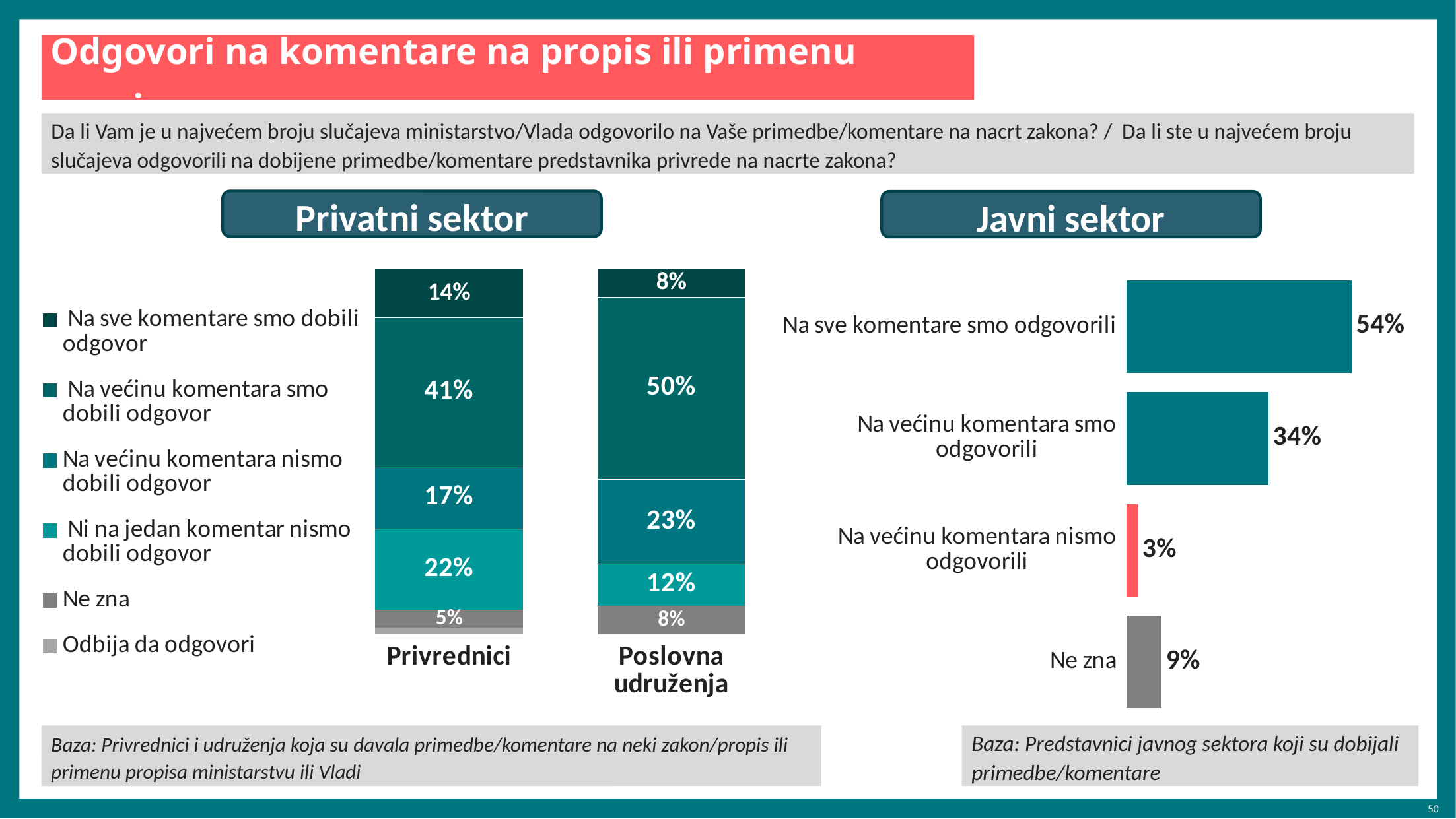
How many entries does the legend of the Privatni sektor chart list? 6 In the Privatni sektor chart, what is the difference between the 'Na većinu komentara nismo dobili odgovor' values for Poslovna udruženja and Privrednici? 6% What type of chart is the Privatni sektor chart? Stacked bar chart In the Javni sektor chart, what is the value for 'Na sve komentare smo odgovorili'? 54% In the Privatni sektor chart, what percentage of Privrednici said 'Na većinu komentara smo dobili odgovor'? 41% In the Javni sektor chart, which category has the lowest value? Na većinu komentara nismo odgovorili In the Privatni sektor chart, what is the 'Ne zna' value for Poslovna udruženja? 8% In the Privatni sektor chart, what is the 'Ni na jedan komentar nismo dobili odgovor' value for Privrednici? 22% In the Privatni sektor chart, what percentage of Poslovna udruženja said 'Na sve komentare smo dobili odgovor'? 8% In the Privatni sektor chart, which bar has the larger 'Na većinu komentara smo dobili odgovor' segment, Privrednici or Poslovna udruženja? Poslovna udruženja In the Javni sektor chart, what is the difference between 'Na sve komentare smo odgovorili' and 'Na većinu komentara smo odgovorili'? 20% How many categories are shown in the Javni sektor chart? 4